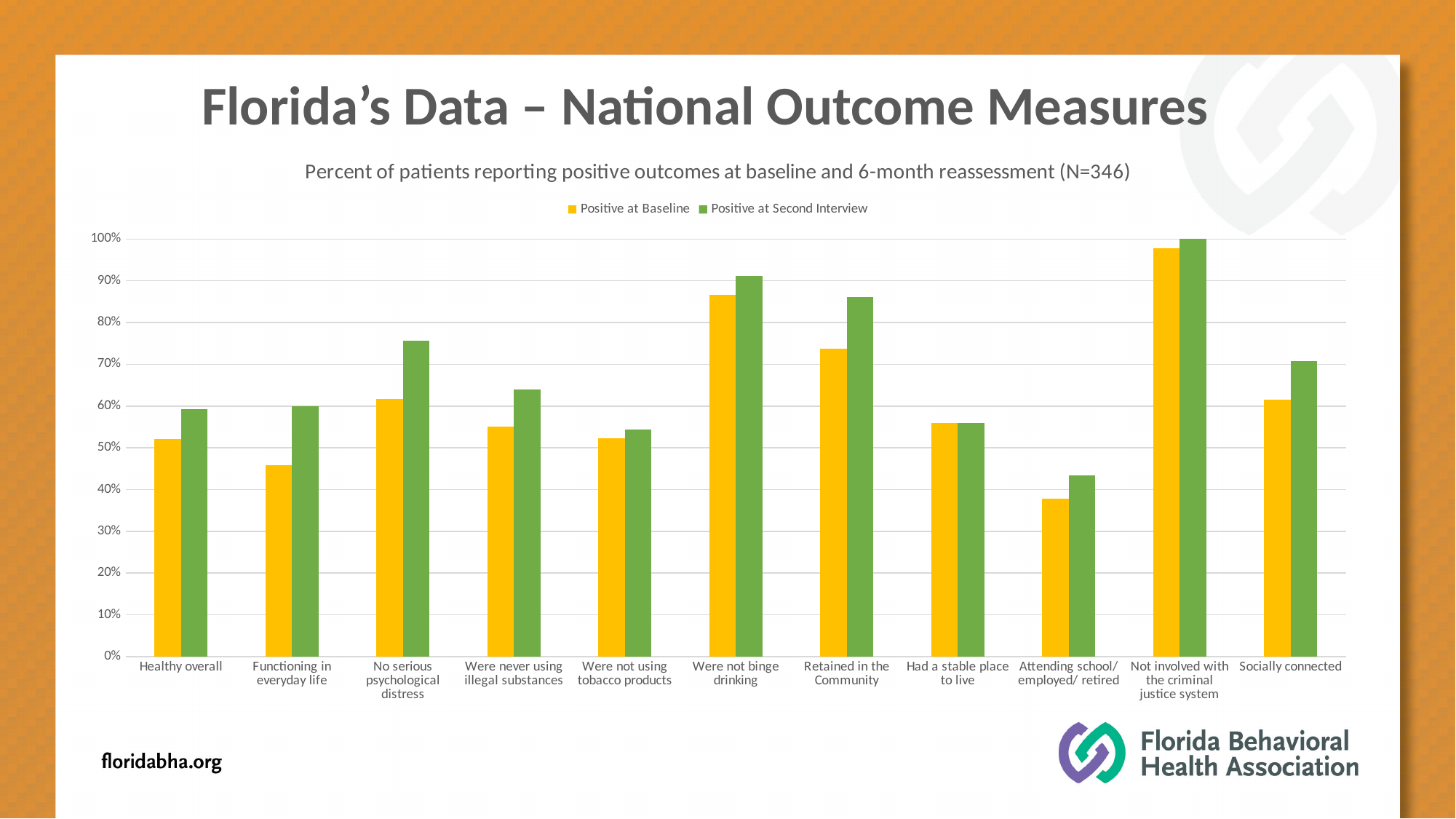
Which category has the highest value for Positive at Baseline? Not involved with the criminal justice system What kind of chart is shown on the slide? Bar chart Which category has the lowest value for Positive at Second Interview? Attending school/ employed/ retired Is the Positive at Second Interview value for Were not binge drinking greater or less than 80%? greater How many outcome categories are shown along the x axis? 11 Is the Positive at Baseline value for Attending school/ employed/ retired greater or less than 40%? less Is the Positive at Baseline value for Functioning in everyday life greater or less than 50%? less Which has the larger Positive at Baseline value: Retained in the Community or Healthy overall? Retained in the Community How many series does the legend list? 2 What colour are the Positive at Baseline bars? Yellow Which category has the lowest value for Positive at Baseline? Attending school/ employed/ retired For No serious psychological distress, which is larger: Positive at Baseline or Positive at Second Interview? Positive at Second Interview